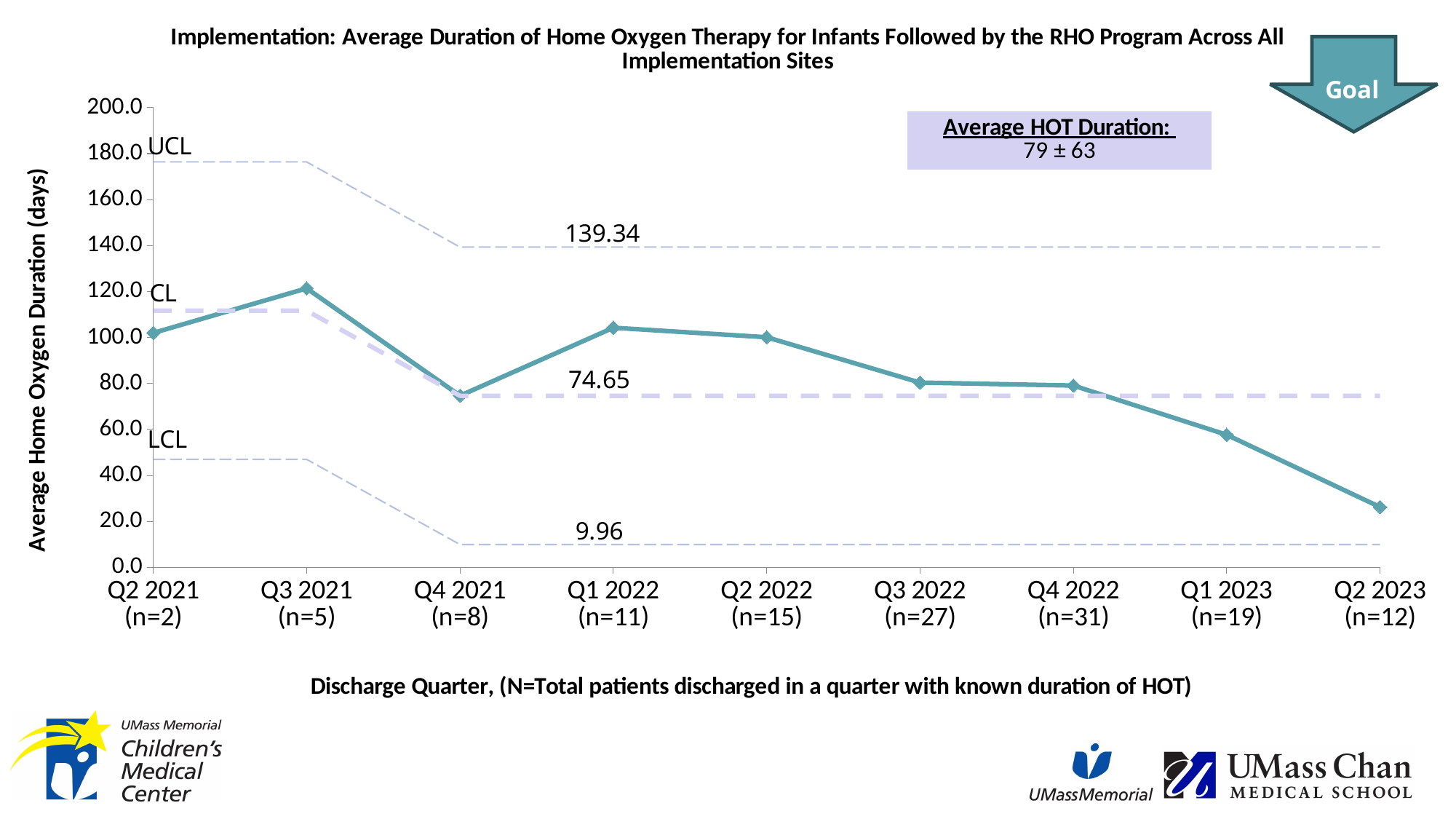
What is the Average HOT Duration stated in the box on the slide? 79 ± 63 What is the value printed for the center line (CL) from Q4 2021 onward? 74.65 What kind of chart is shown on the slide? line chart How many discharge quarters are plotted along the x axis? 9 Is the average home oxygen duration for Q3 2021 greater or less than 100? greater What is the value printed for the lower control limit (LCL) from Q4 2021 onward? 9.96 From Q4 2022 to Q2 2023, does the average home oxygen duration rise or fall? fall Which quarter has a higher average home oxygen duration, Q1 2022 or Q1 2023? Q1 2022 Is the average home oxygen duration for Q2 2023 greater or less than 40? less Which discharge quarter has the lowest average home oxygen duration? Q2 2023 What is the value printed for the upper control limit (UCL) from Q4 2021 onward? 139.34 Which discharge quarter has the highest average home oxygen duration? Q3 2021